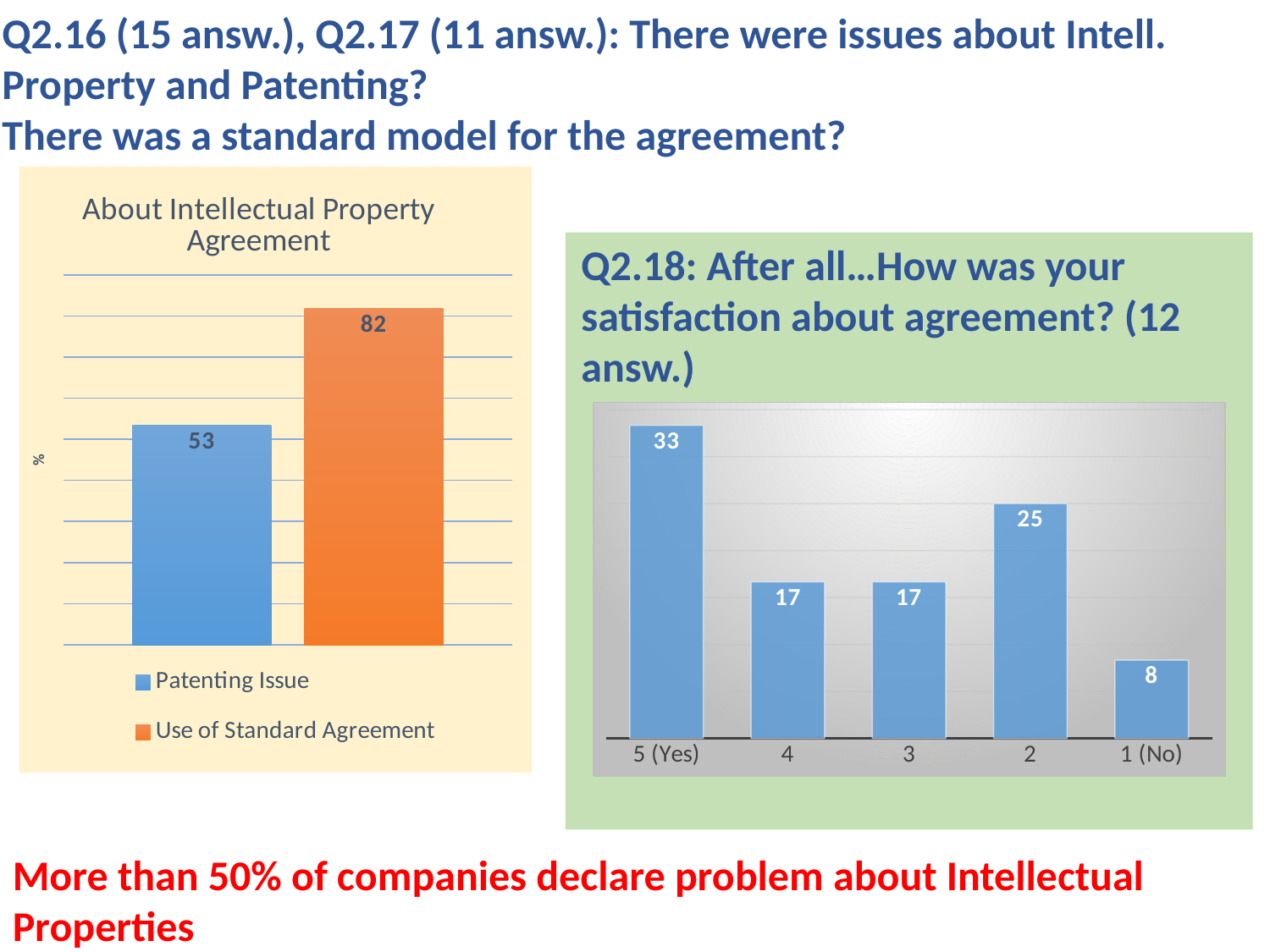
In the 'About Intellectual Property Agreement' chart, what is the value for Patenting Issue? 53 In the 'About Intellectual Property Agreement' chart, what is the value for Use of Standard Agreement? 82 What kind of chart is the Q2.18 satisfaction chart on the right? Bar chart In the 'About Intellectual Property Agreement' chart, what colour is the Use of Standard Agreement bar? Orange In the 'About Intellectual Property Agreement' chart, how many series does the legend list? 2 In the Q2.18 satisfaction chart on the right, what is the value for 5 (Yes)? 33 In the Q2.18 satisfaction chart on the right, what is the value for 1 (No)? 8 In the Q2.18 satisfaction chart on the right, which category has the highest value? 5 (Yes) In the Q2.18 satisfaction chart on the right, which is larger: the value for 2 or the value for 4? 2 In the Q2.18 satisfaction chart on the right, which category has the lowest value? 1 (No) In the 'About Intellectual Property Agreement' chart, what is the difference between Use of Standard Agreement and Patenting Issue? 29 In the Q2.18 satisfaction chart on the right, how many categories are shown? 5